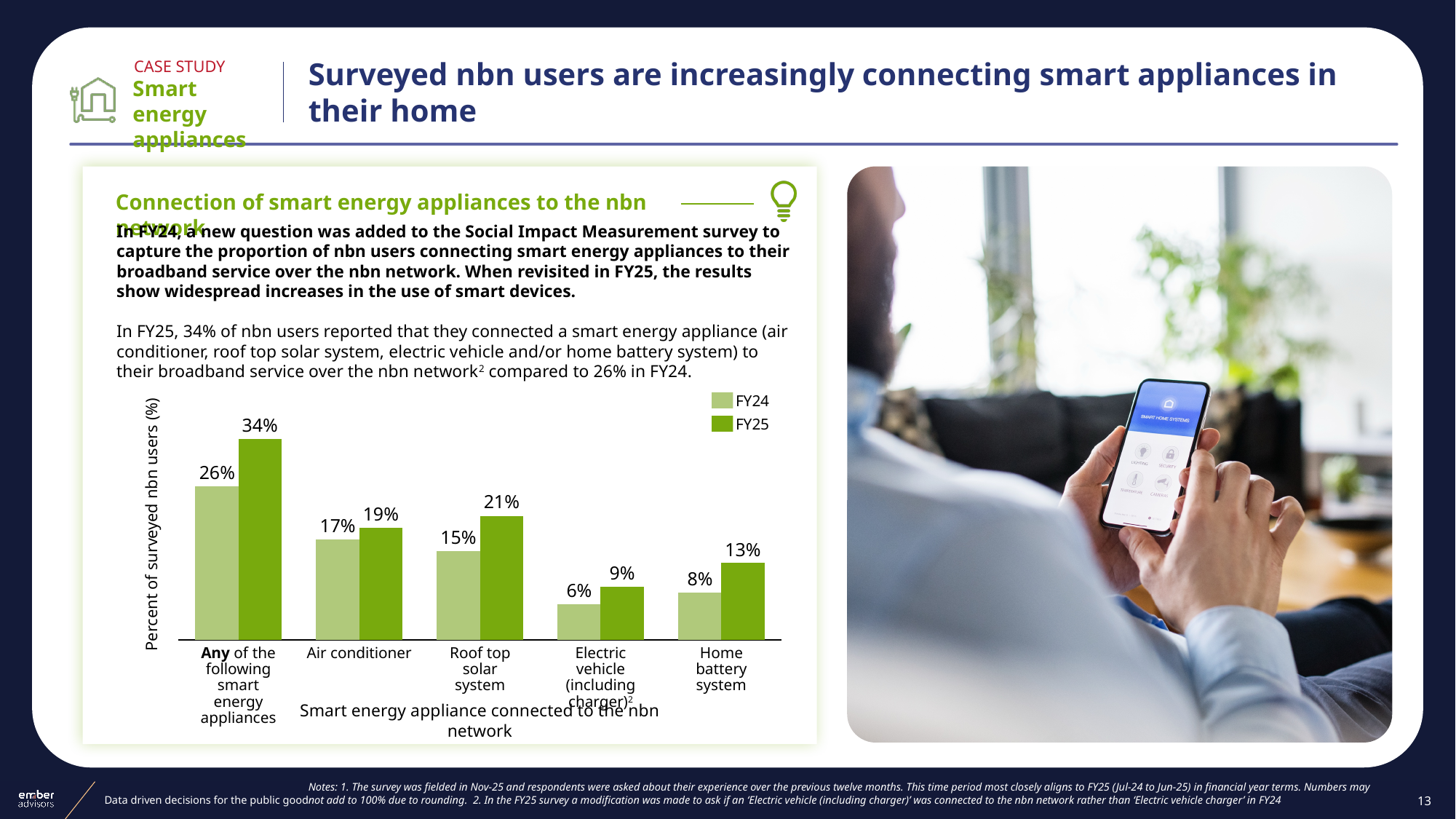
Which is larger: the FY25 value for Electric vehicle (including charger) or the FY24 value for Home battery system? FY25 Electric vehicle (including charger) What percentage of surveyed nbn users connected a home battery system in FY25? 13% What type of chart is shown on the slide? Bar chart How many series does the chart legend list? 2 What is the difference between the FY25 values for Roof top solar system and Air conditioner? 2 percentage points What was the FY24 value for Roof top solar system? 15% Which category has the highest FY25 value? Any of the following smart energy appliances Which appliance category has the lowest FY24 value? Electric vehicle (including charger) What percentage of surveyed nbn users connected an air conditioner to the nbn network in FY25? 19% What is the label of the y axis of the chart? Percent of surveyed nbn users (%) By how many percentage points did the 'Any of the following smart energy appliances' value increase from FY24 to FY25? 8 percentage points How many appliance categories are shown on the x axis of the chart? 5